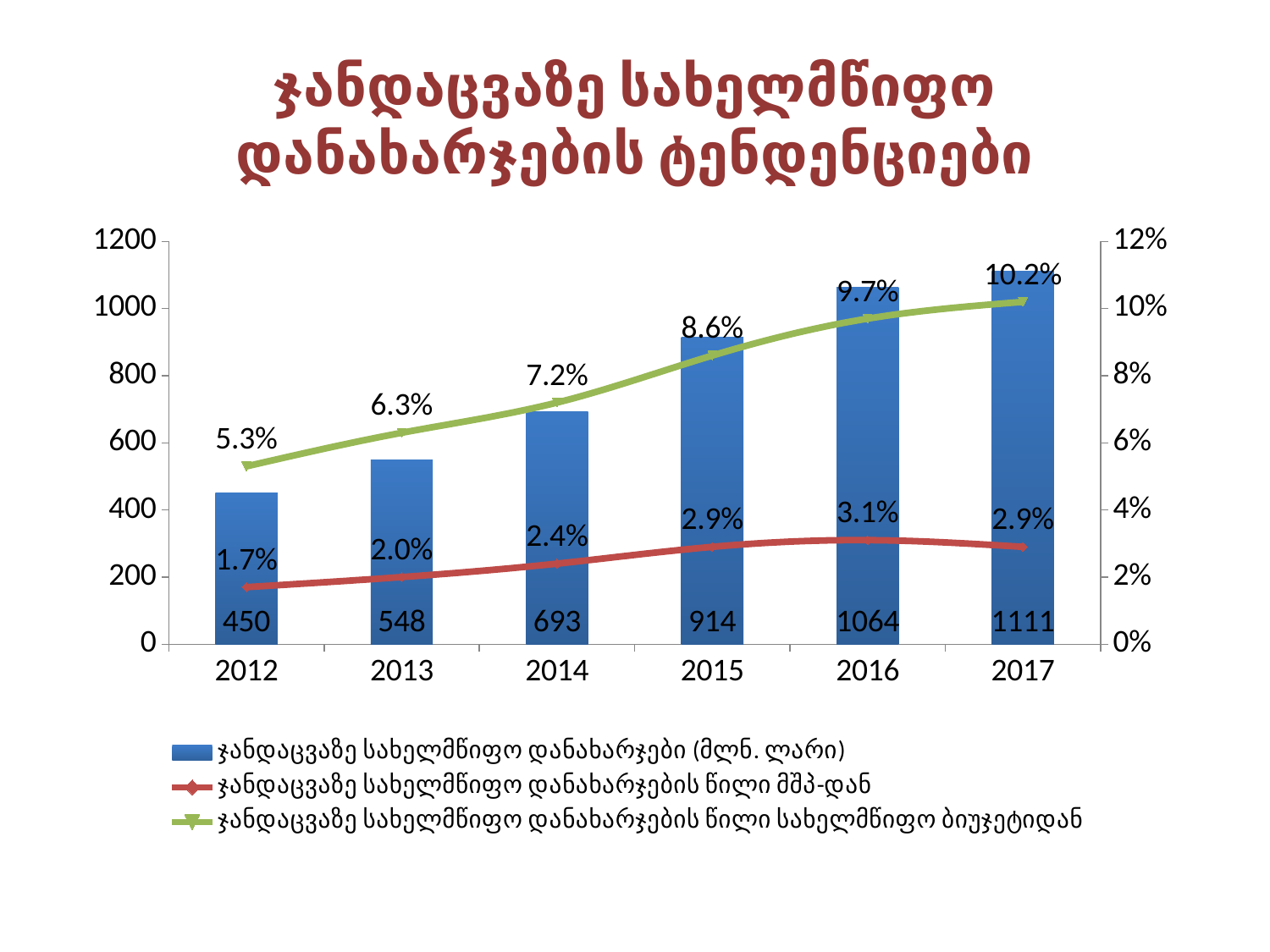
What kind of chart is this? Combined bar and line chart Which is larger: the blue bar value for 2013 or for 2014? 2014 What is the value of the green line series (წილი სახელმწიფო ბიუჯეტიდან) for 2015? 8.6% What is the difference between the blue bar values for 2017 and 2016? 47 How many years are shown on the x axis? 6 In which year is the green line series (წილი სახელმწიფო ბიუჯეტიდან) lowest? 2012 Is the blue bar value for 2015 greater or less than 800? greater In which year is the blue bar series (ჯანდაცვაზე სახელმწიფო დანახარჯები) highest? 2017 What is the value of the blue bar series (ჯანდაცვაზე სახელმწიფო დანახარჯები (მლნ. ლარი)) for 2014? 693 Does the green line series (წილი სახელმწიფო ბიუჯეტიდან) rise or fall from 2012 to 2017? rise What is the value of the red line series (წილი მშპ-დან) for 2016? 3.1% How many series does the legend list? 3